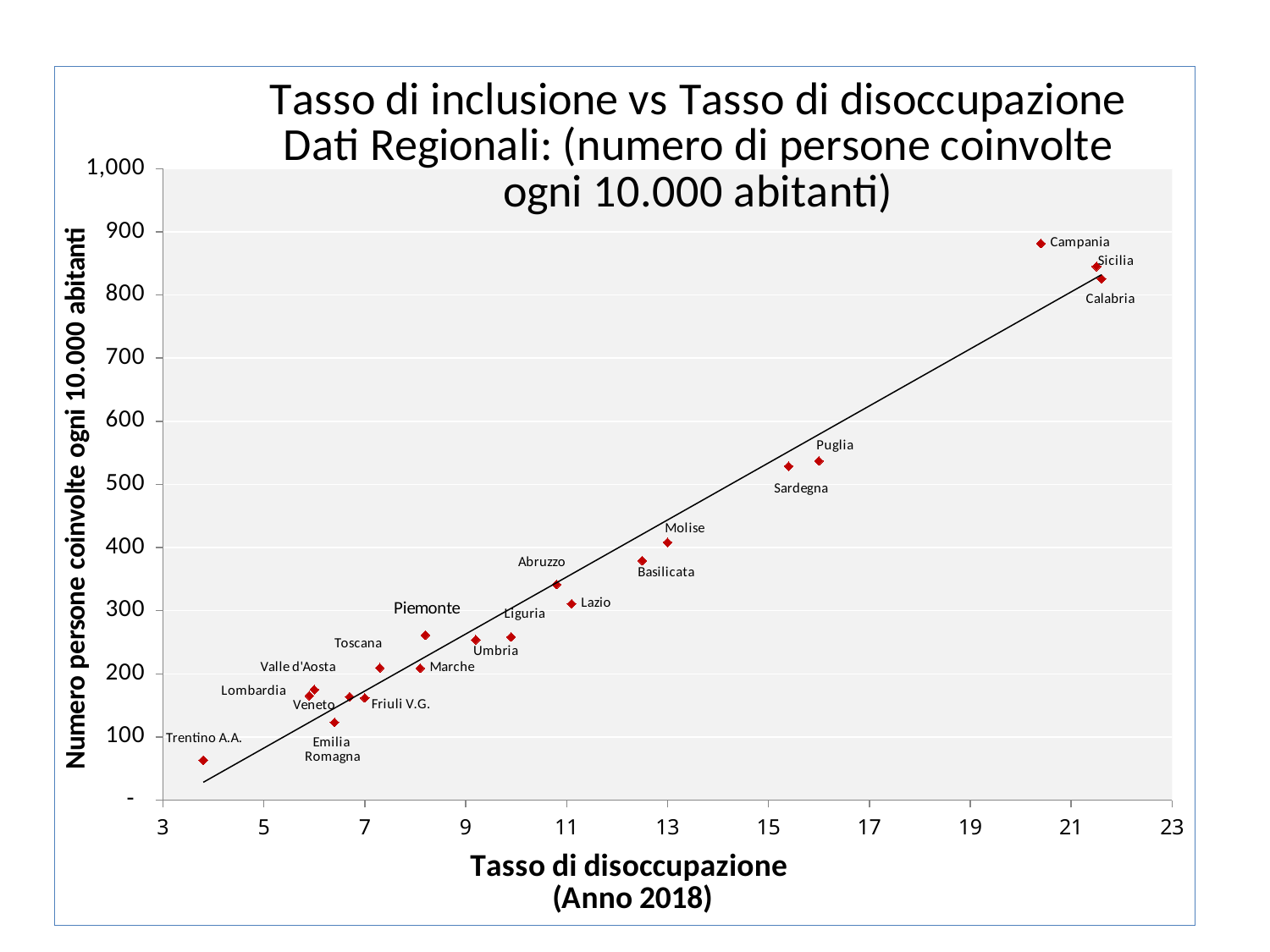
Which region has the lowest unemployment rate (Tasso di disoccupazione) on the chart? Trentino A.A. What kind of chart is shown on the slide? Scatter chart Which region has the highest number of persons involved per 10,000 inhabitants? Campania Which has a higher number of persons involved per 10,000 inhabitants, Piemonte or Marche? Piemonte Is the value for Emilia Romagna on the vertical axis greater or less than 200? less Is the value for Trentino A.A. on the vertical axis greater or less than 100? less Which has a higher number of persons involved per 10,000 inhabitants, Campania or Puglia? Campania What is the label of the horizontal axis? Tasso di disoccupazione (Anno 2018) Is the value for Campania on the vertical axis greater or less than 800? greater As the unemployment rate increases along the x axis, do the plotted values generally rise or fall? Rise Which region has the lowest number of persons involved per 10,000 inhabitants? Trentino A.A.